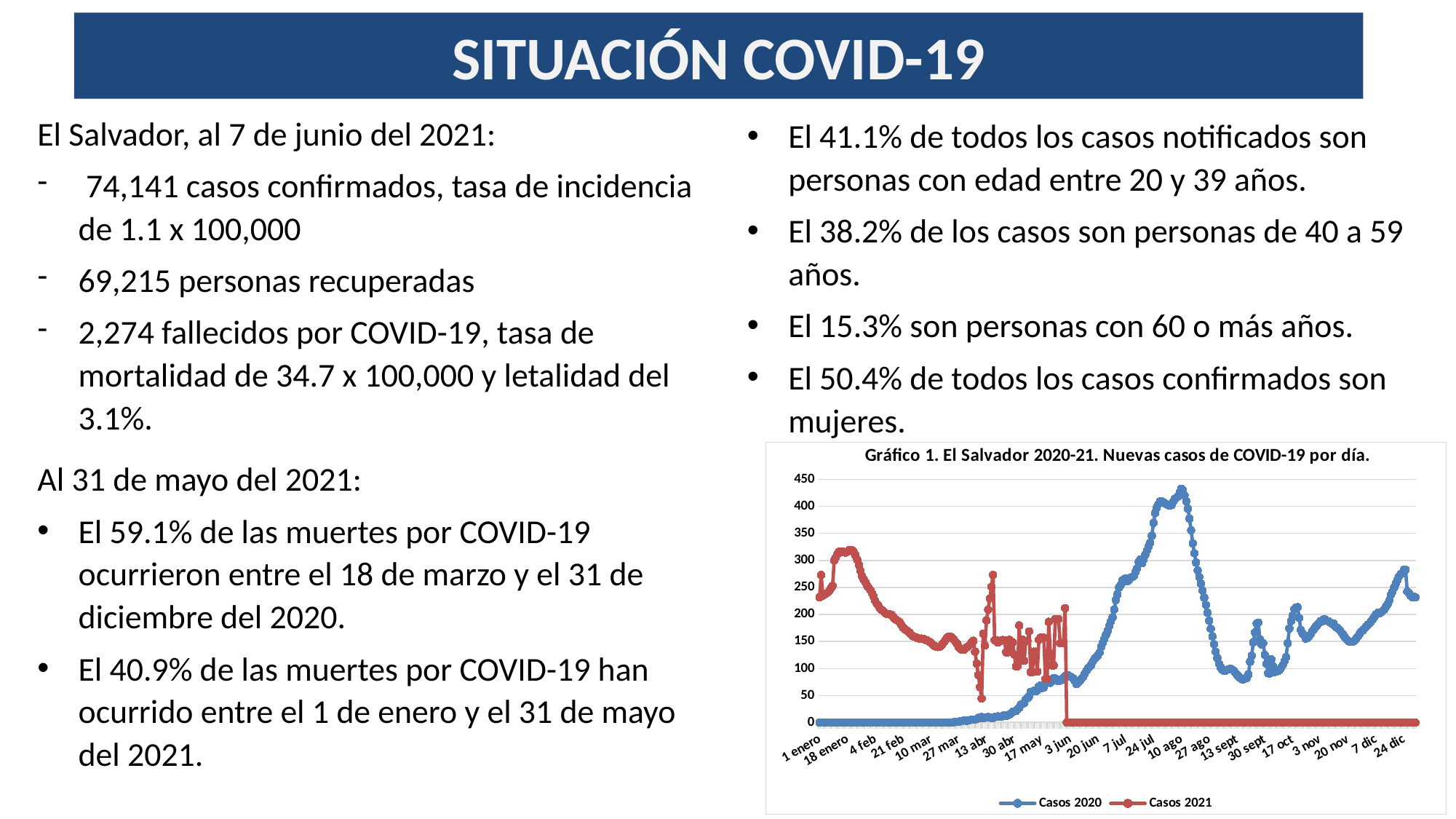
Which colour is used for the Casos 2021 series in Gráfico 1? red In Gráfico 1, is the value of Casos 2020 around 13 sept greater or less than 150? less How many series does the legend of Gráfico 1 list? 2 What kind of chart is Gráfico 1 on the slide? line chart In Gráfico 1, is the value of Casos 2020 on 1 enero greater or less than 50? less In Gráfico 1, is the value of Casos 2021 around 18 enero greater or less than 250? greater What is the title of the chart on the slide? Gráfico 1. El Salvador 2020-21. Nuevas casos de COVID-19 por día. In Gráfico 1, does the Casos 2021 series rise or fall between 18 enero and 10 mar? fall In Gráfico 1, which series reaches the higher peak value, Casos 2020 or Casos 2021? Casos 2020 In Gráfico 1, does the Casos 2020 series rise or fall between 20 jun and 10 ago? rise